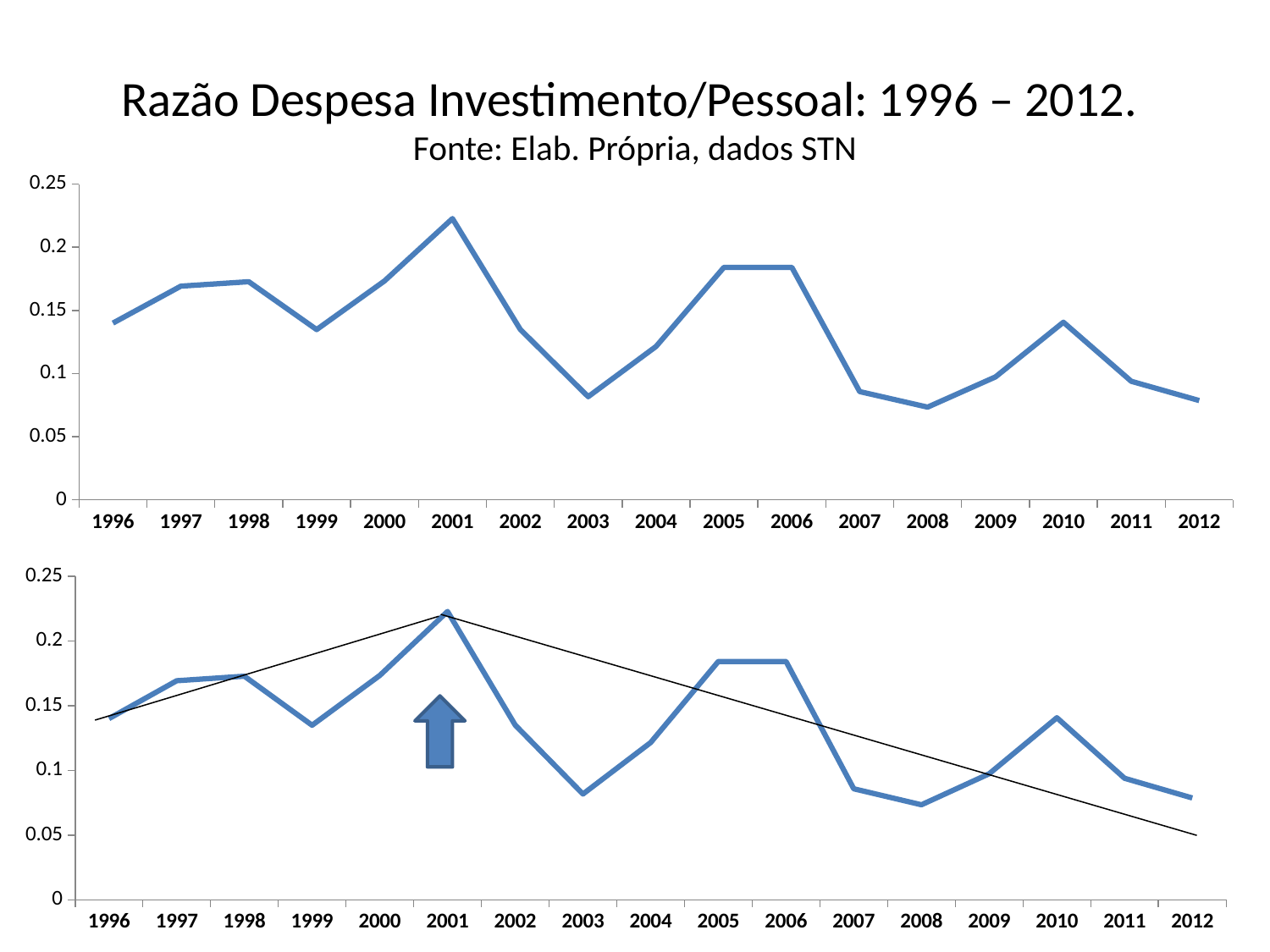
In the top chart, how many years are plotted along the x axis? 17 In the top chart, which year has the highest value? 2001 In the bottom chart, is the value for 2003 greater or less than 0.1? less In the top chart, is the value for 2001 greater or less than 0.2? greater In the bottom chart, which is larger, the value for 1997 or the value for 2003? 1997 In the top chart, is the value for 2005 greater or less than 0.15? greater In the bottom chart, do the values rise or fall from 2003 to 2005? rise In the top chart, do the values rise or fall from 2001 to 2003? fall What kind of chart is the top chart on the slide? line chart In the top chart, which is larger, the value for 2001 or the value for 2005? 2001 In the bottom chart, which year does the blue arrow point to? 2001